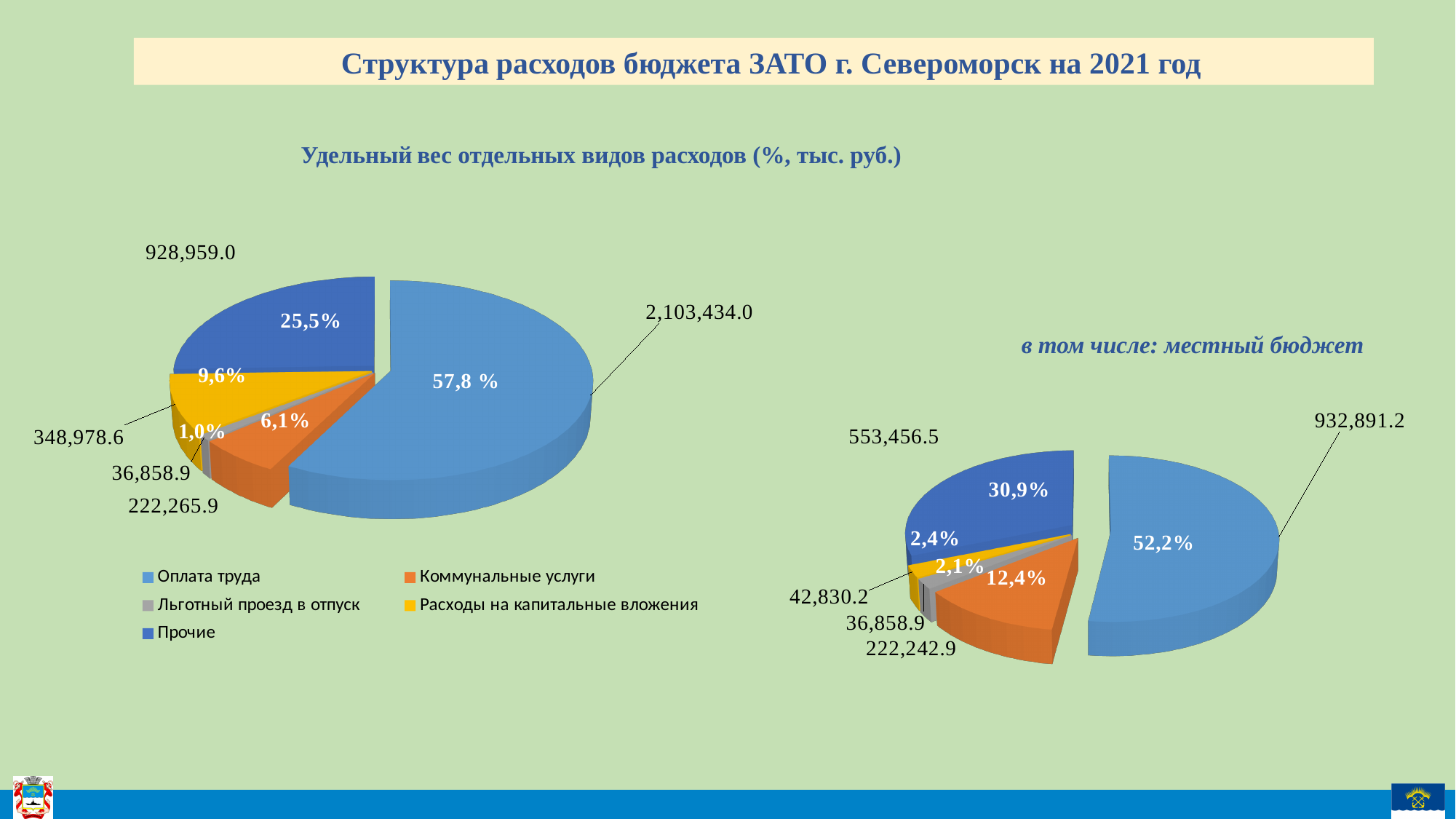
In the left pie chart 'Удельный вес отдельных видов расходов', what is the difference between the values for 'Оплата труда' and 'Прочие'? 1,174,475.0 In the left pie chart 'Удельный вес отдельных видов расходов', which category has the smallest share? Льготный проезд в отпуск In the right pie chart 'в том числе: местный бюджет', which is larger: the value for 'Расходы на капитальные вложения' or the value for 'Льготный проезд в отпуск'? Расходы на капитальные вложения What kind of chart is used on the left of the slide, under the heading 'Удельный вес отдельных видов расходов (%, тыс. руб.)'? Pie chart How many categories does the legend on the slide list? 5 In the left pie chart 'Удельный вес отдельных видов расходов', what is the value for 'Прочие'? 928,959.0 In the right pie chart 'в том числе: местный бюджет', what share does 'Прочие' have? 30,9% In the left pie chart 'Удельный вес отдельных видов расходов', what share does 'Оплата труда' have? 57,8 % In the right pie chart 'в том числе: местный бюджет', which category has the largest share? Оплата труда In the left pie chart 'Удельный вес отдельных видов расходов', what is the value for 'Расходы на капитальные вложения'? 348,978.6 In the right pie chart 'в том числе: местный бюджет', what is the value for 'Коммунальные услуги'? 222,242.9 Which colour represents 'Коммунальные услуги' in the pie charts? Orange